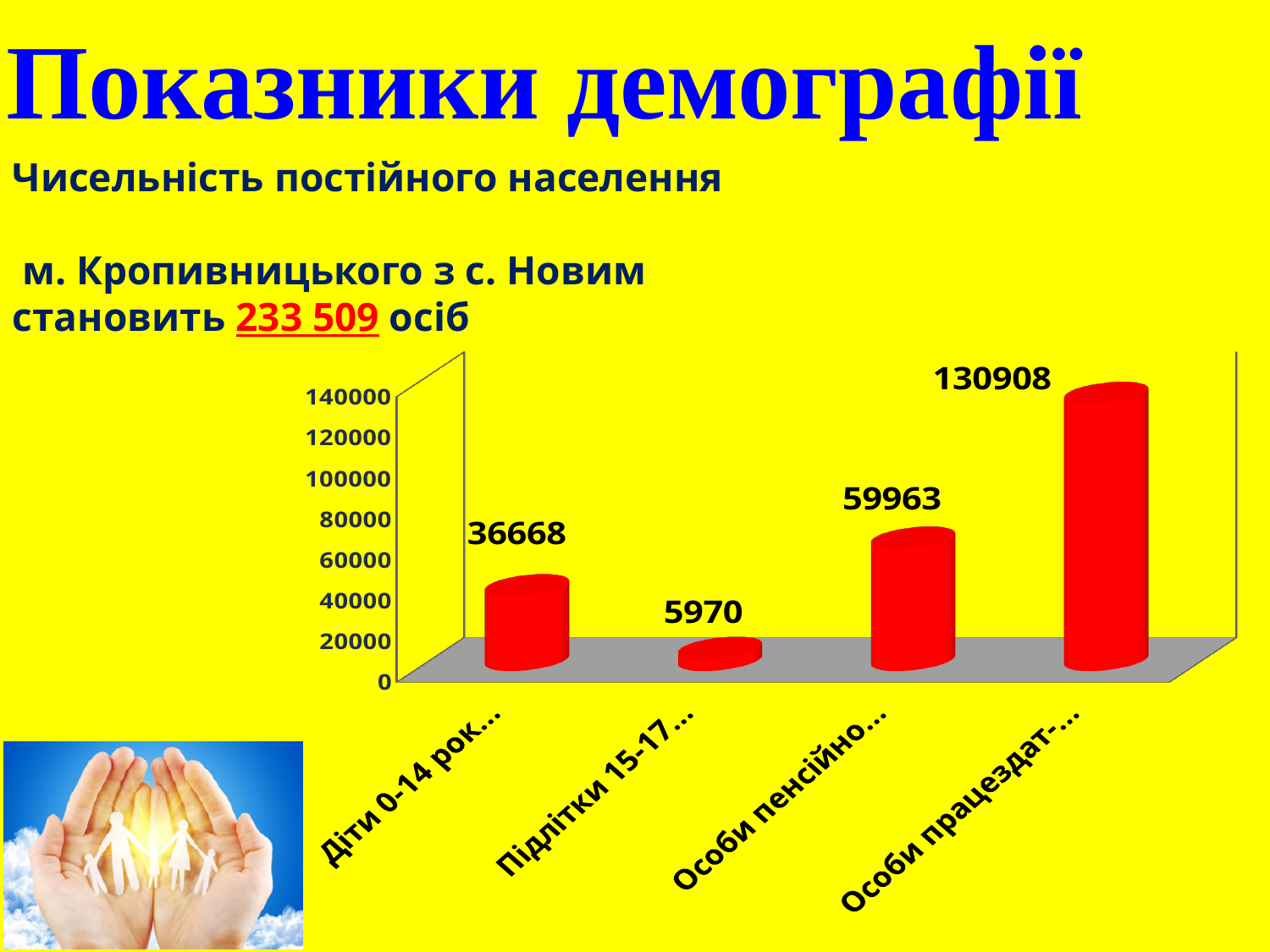
Which category has the lowest value on the chart? Підлітки 15-17... Which is larger: the value for "Діти 0-14..." or the value for "Підлітки 15-17..."? Діти 0-14... Is the value for the "Особи працездат..." category greater or less than 120000? greater Which category has the highest value on the chart? Особи працездат... What is the value shown for the category beginning "Особи пенсійно"? 59963 How many categories are plotted on the chart? 4 What is the difference between the values for the "Особи пенсійно..." category and the "Діти 0-14..." category? 23295 What is the value shown for the category beginning "Особи працездат"? 130908 What kind of chart is shown on the slide? bar chart What is the value shown for the category beginning "Діти 0-14"? 36668 What is the value shown for the category beginning "Підлітки 15-17"? 5970 What is the highest tick value shown on the vertical axis of the chart? 140000